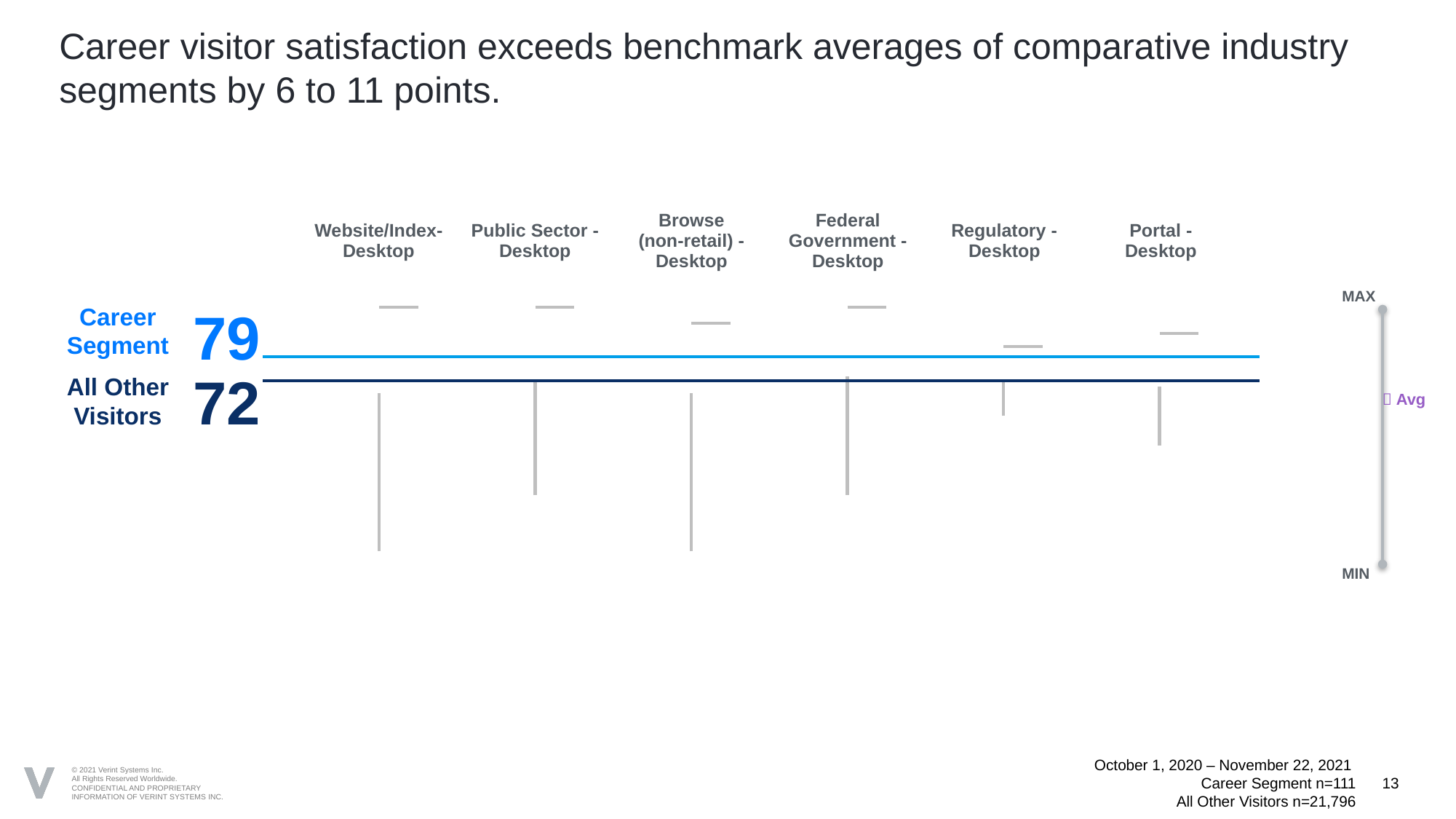
Which benchmark segment is listed last (rightmost) on the chart? Portal - Desktop Is the Career Segment score greater or less than 72? greater What is the satisfaction score for the Career Segment? 79 By how many points does the Career Segment score exceed the All Other Visitors score? 7 How many comparative industry benchmark segments are shown across the top of the chart? 6 Which benchmark segment is listed first (leftmost) on the chart? Website/Index-Desktop What is the satisfaction score for All Other Visitors? 72 Which group has the higher satisfaction score, Career Segment or All Other Visitors? Career Segment According to the slide title, by how many points does career visitor satisfaction exceed the benchmark averages? 6 to 11 points What is the sample size (n) for the Career Segment shown on the slide? 111 What is the sample size (n) for All Other Visitors shown on the slide? 21,796